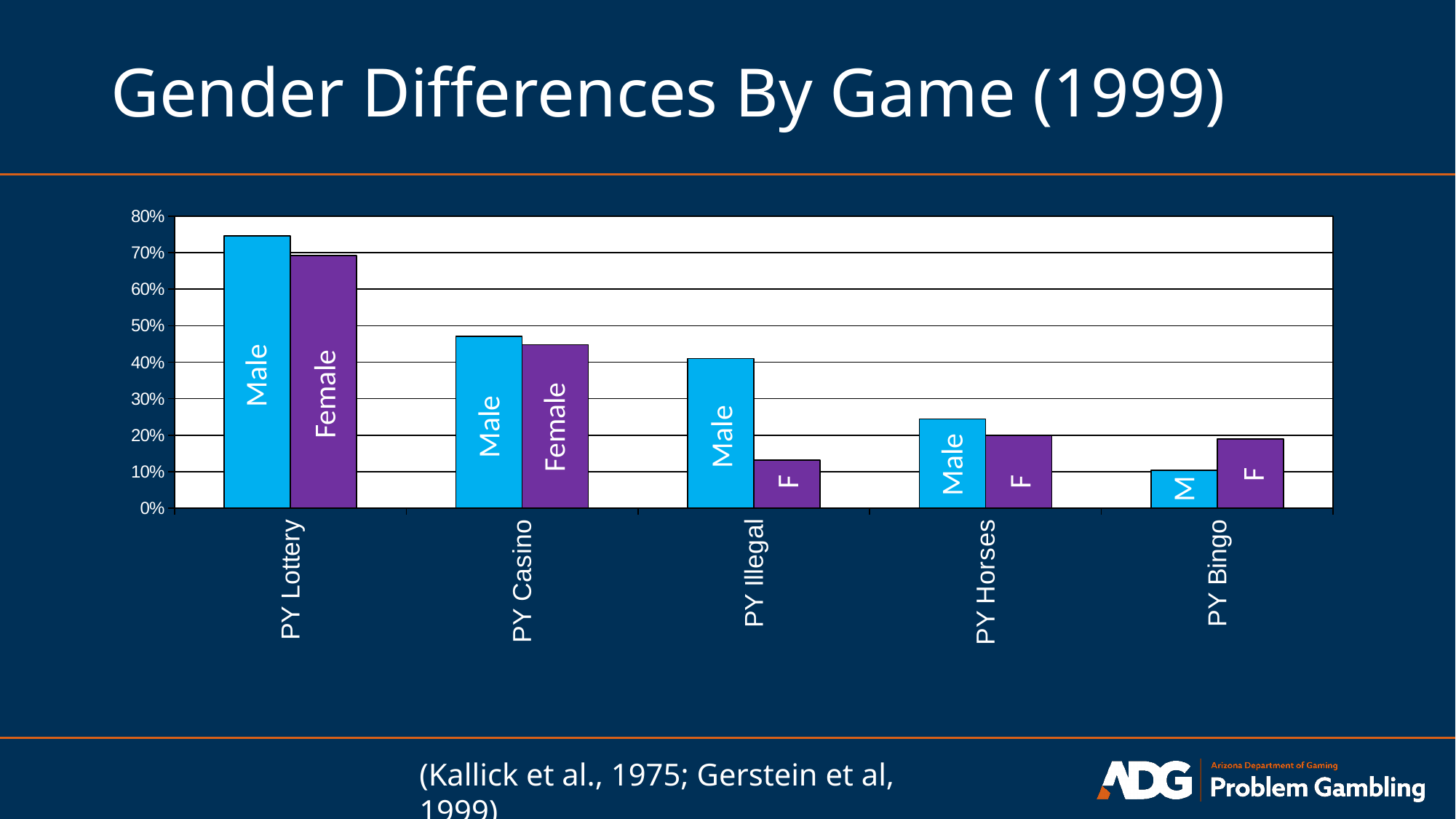
What is the title of the slide containing the chart? Gender Differences By Game (1999) Is the Male value for PY Casino greater or less than 50%? less Which game category has the highest Male bar? PY Lottery Do the Male values rise or fall moving from PY Lottery to PY Bingo along the x axis? fall Which game category has the lowest Male bar? PY Bingo What kind of chart is shown on the slide? bar chart For PY Bingo, which is larger, the Male bar or the Female bar? Female Is the Male value for PY Illegal greater or less than 30%? greater Is the Female value for PY Illegal greater or less than 20%? less For PY Illegal, which is larger, the Male bar or the Female bar? Male How many game categories are shown on the x axis? 5